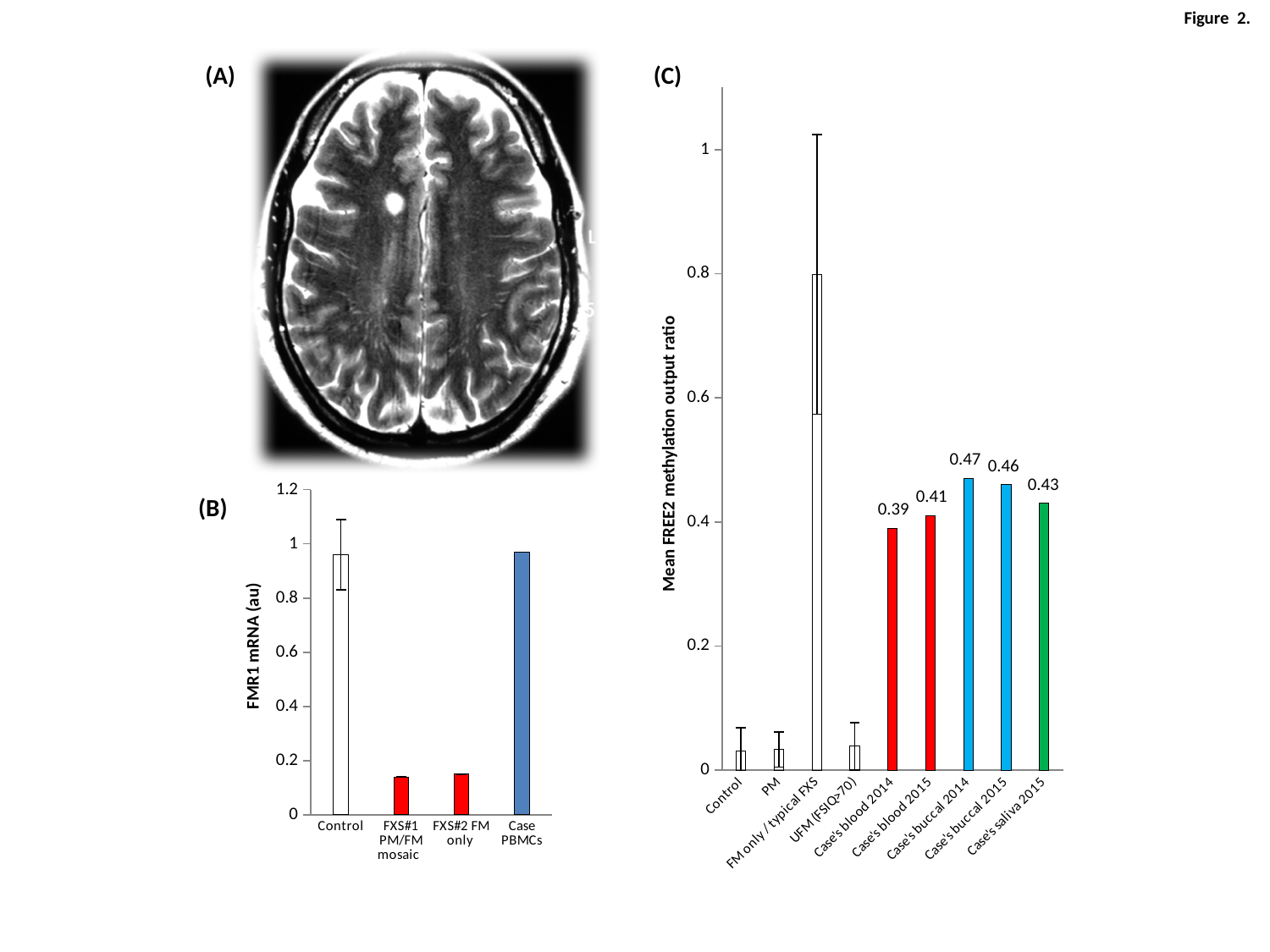
In chart (C), what is the mean FREE2 methylation output ratio for Case's blood 2014? 0.39 In chart (C), how many categories are shown on the x axis? 9 In chart (B), is the value for Control greater or less than 0.8? greater In chart (C), is the value for FM only / typical FXS greater or less than 0.6? greater In chart (B), which is larger, the value for Case PBMCs or FXS#1 PM/FM mosaic? Case PBMCs In chart (C), what is the value for Case's buccal 2015? 0.46 In chart (C), what is the value for Case's saliva 2015? 0.43 In chart (C), which category has the highest mean FREE2 methylation output ratio? FM only / typical FXS What kind of chart is chart (B)? Bar chart In chart (C), what is the difference between the values for Case's buccal 2014 and Case's blood 2014? 0.08 In chart (C), which is larger, the value for Case's blood 2015 or Case's saliva 2015? Case's saliva 2015 In chart (B), is the value for FXS#2 FM only greater or less than 0.4? less